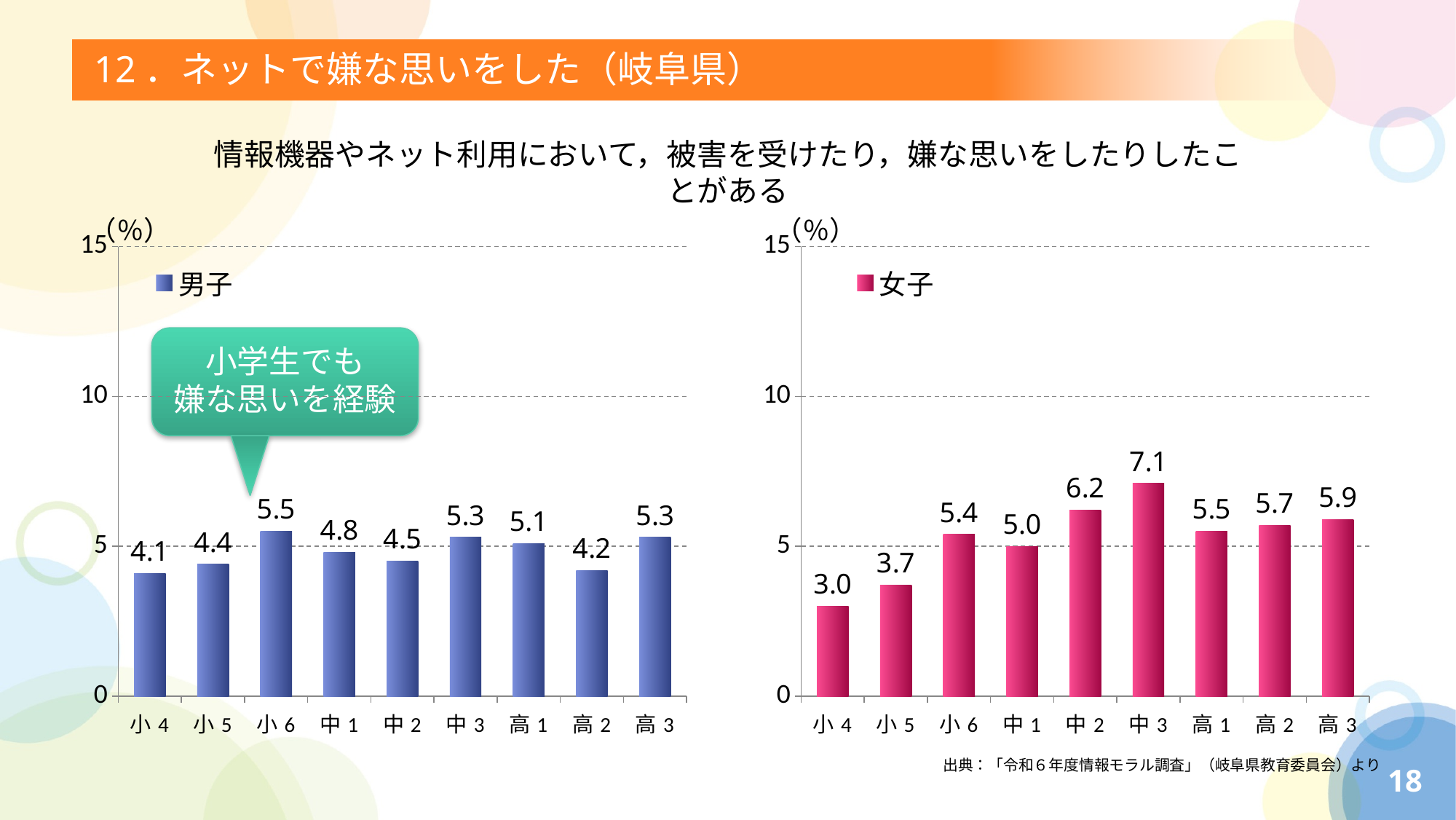
In the 男子 (boys) chart on the left, what is the difference between the values for 小6 and 高2? 1.3 In the 女子 (girls) chart on the right, is the value for 中3 greater or less than 5? greater In the 男子 (boys) chart on the left, which category has the lowest value? 小4 In the 男子 (boys) chart on the left, which category has the highest value? 小6 In the 女子 (girls) chart on the right, what is the value for 小4? 3.0 In the 女子 (girls) chart on the right, which category has the highest value? 中3 Which is larger: the value for 中2 in the 男子 chart on the left or the value for 中2 in the 女子 chart on the right? 女子 (6.2) What kind of chart is the 女子 (girls) chart on the right? bar chart How many categories are shown on the x axis of the 男子 (boys) chart on the left? 9 In the 男子 (boys) chart on the left, what is the value for 小6? 5.5 In the 女子 (girls) chart on the right, what is the value for 中3? 7.1 In the 女子 (girls) chart on the right, what is the difference between the values for 中3 and 小4? 4.1